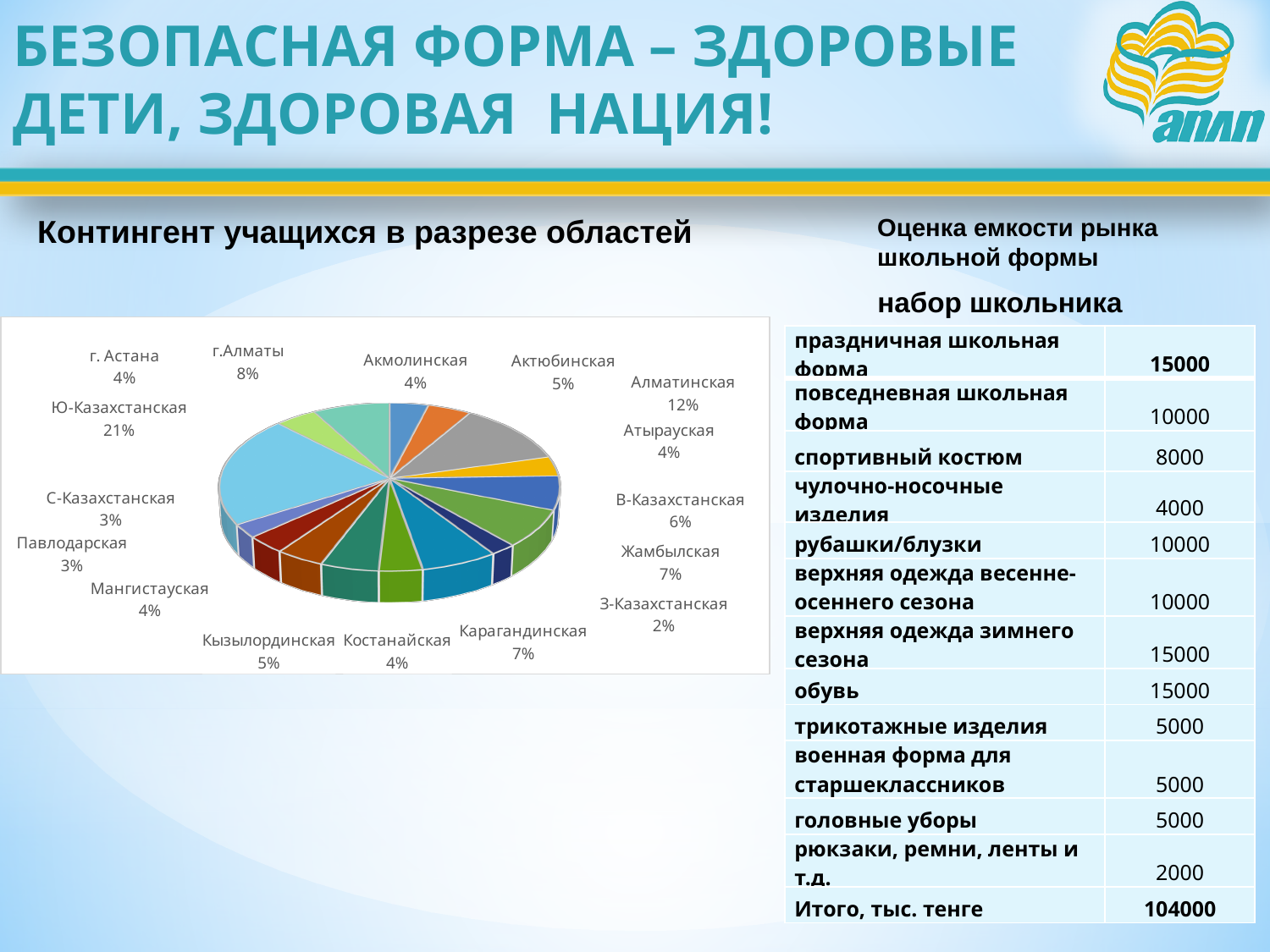
What share of the pie does Ю-Казахстанская have? 21% Which region has the smallest slice of the pie? З-Казахстанская How many regions (slices) are shown in the pie chart? 16 What is the difference in percentage points between г.Алматы and г. Астана? 4 Which region has the largest slice of the pie? Ю-Казахстанская What is the title of the chart on the slide? Контингент учащихся в разрезе областей What is the difference in percentage points between Ю-Казахстанская and Алматинская? 9 Which is larger, the share for Актюбинская or the share for Павлодарская? Актюбинская What share of the pie does г.Алматы have? 8% What kind of chart is shown on the slide? pie chart What share of the pie does Алматинская have? 12% What share of the pie does Жамбылская have? 7%